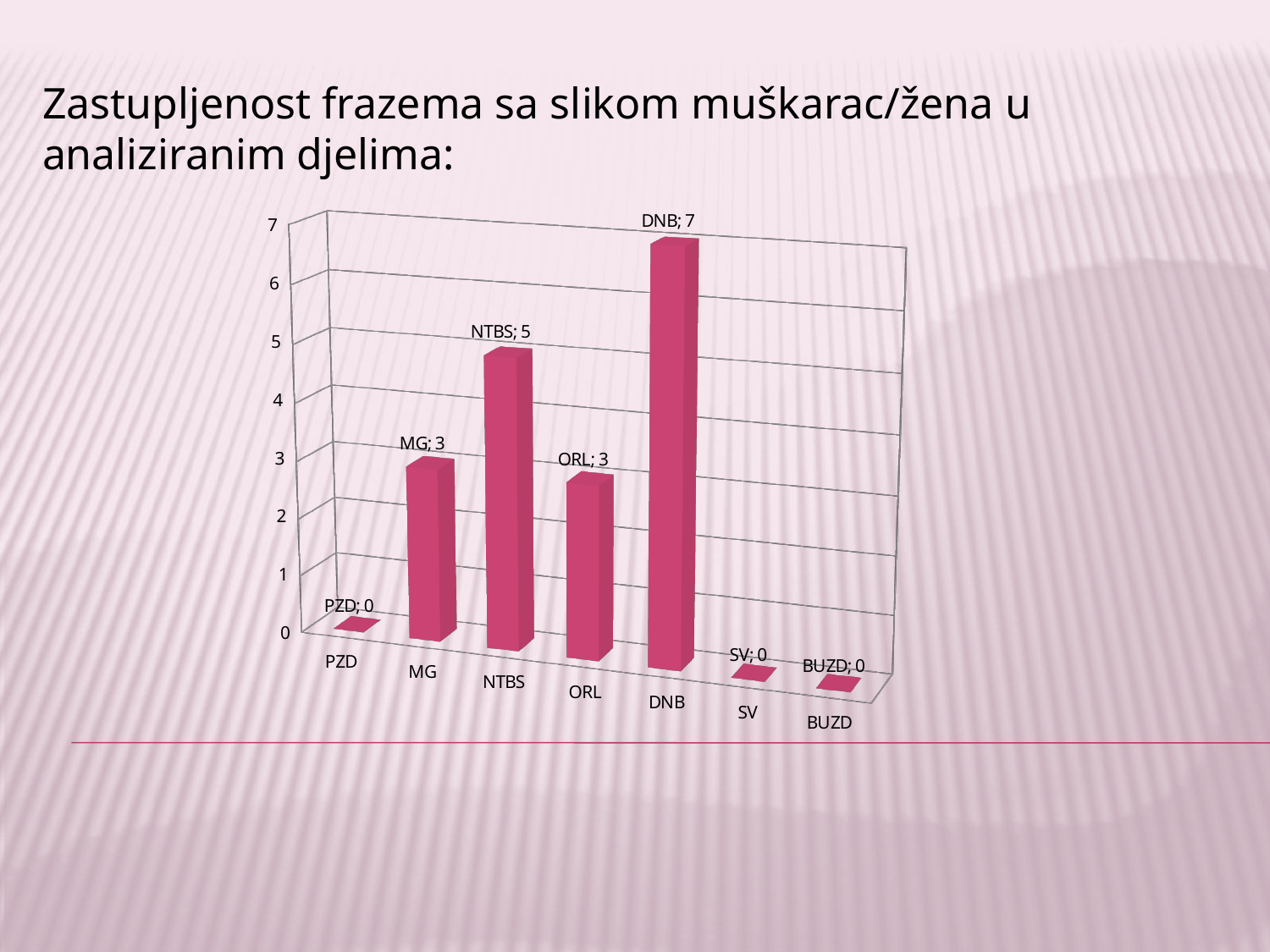
What is the highest value shown on the vertical axis? 7 What is the difference between the values for DNB and NTBS? 2 How many categories are shown on the x axis? 7 What kind of chart is shown on the slide? bar chart Which category has the highest value? DNB What is the value for NTBS? 5 What is the value for MG? 3 How many categories have a value of 0? 3 What is the value for SV? 0 What is the value for DNB? 7 Which is larger, the value for NTBS or the value for MG? NTBS What is the difference between the values for NTBS and ORL? 2